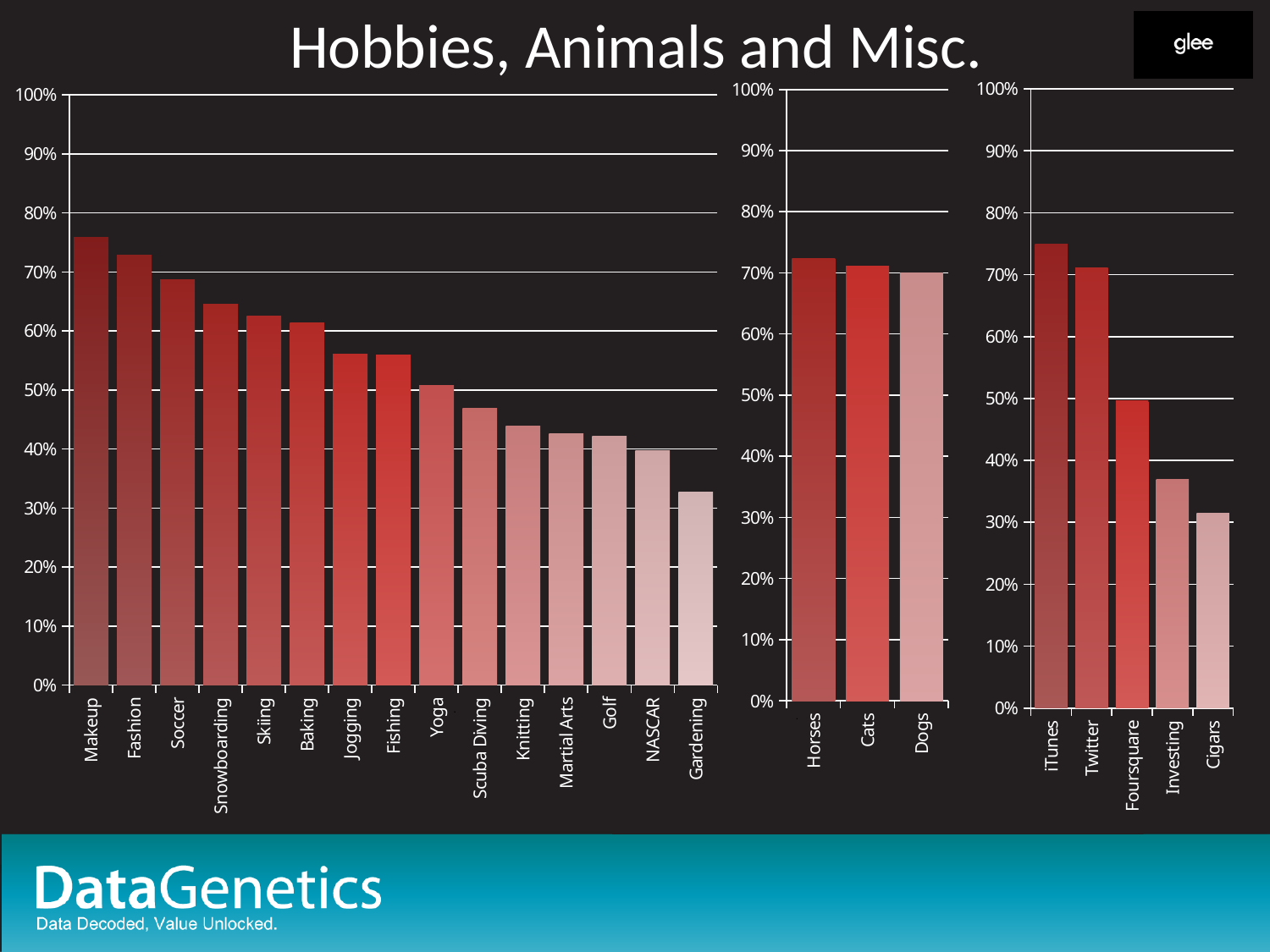
In the right chart, which category has the highest value? iTunes In the right chart, is the value for Investing greater or less than 40%? less In the right chart, which category has the lowest value? Cigars What kind of chart is the left chart on the slide? bar chart In the left chart, which category has the lowest value? Gardening In the left chart, how many categories are plotted? 15 In the left chart, is the value for Gardening greater or less than 40%? less In the left chart, which category has the highest value? Makeup In the left chart, is the value for Snowboarding greater or less than 60%? greater In the left chart, do the values rise or fall from left to right along the x axis? fall In the middle chart, how many categories are plotted? 3